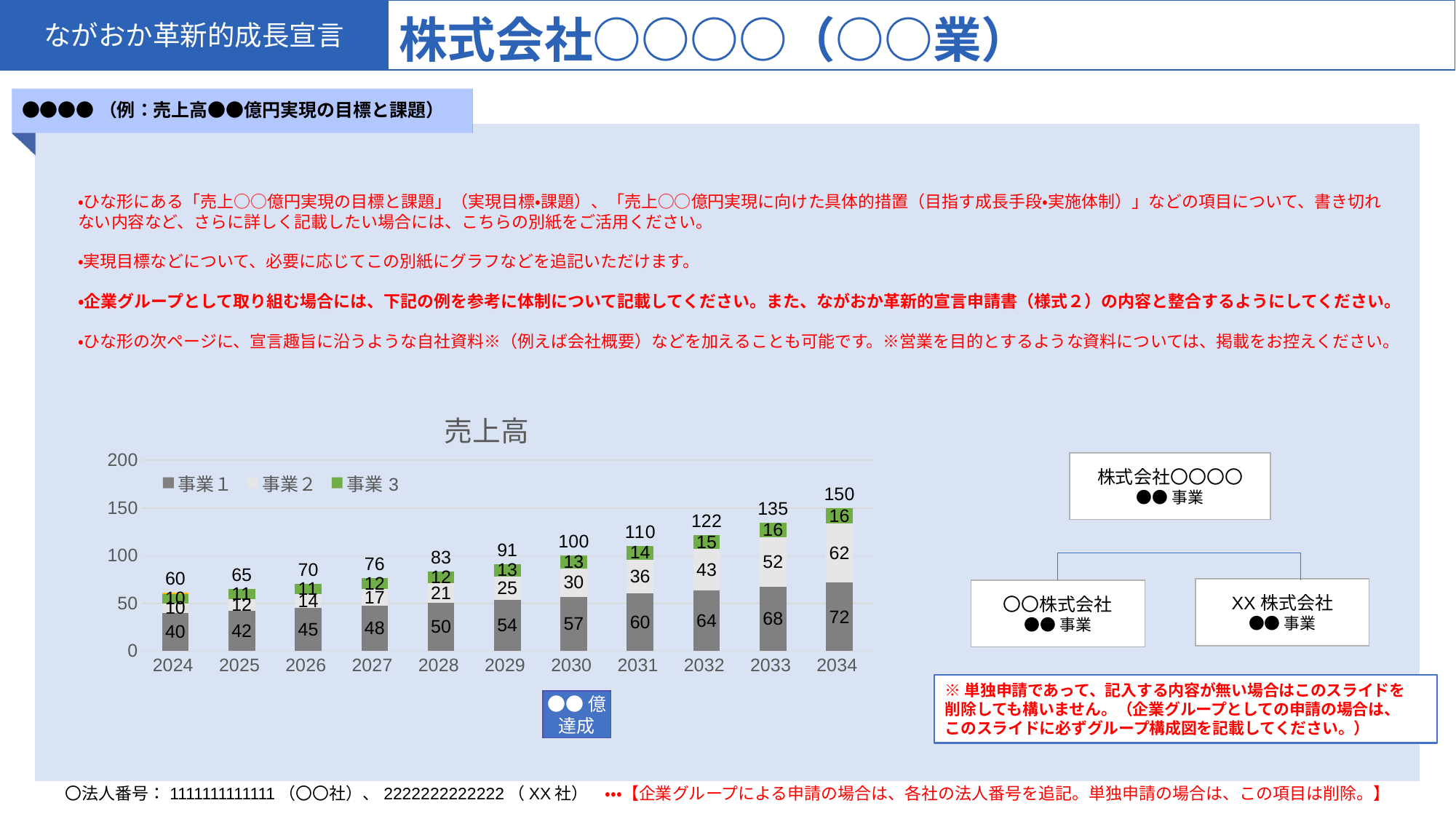
What is the value of 事業1 in 2024? 40 How many series does the legend of the 売上高 chart list? 3 Do the total 売上高 values rise or fall from 2024 to 2034? rise What is the difference between the 事業1 values for 2034 and 2024? 32 Which year has the lowest total 売上高? 2024 How many years are shown on the x axis of the 売上高 chart? 11 What is the total of the stacked bar for 2032? 122 What is the value of 事業3 in 2030? 13 What type of chart is shown under the title 売上高? stacked bar chart What is the value of 事業2 in 2034? 62 Which year has the highest total 売上高? 2034 Which is larger in 2031, the value of 事業2 or the value of 事業3? 事業2